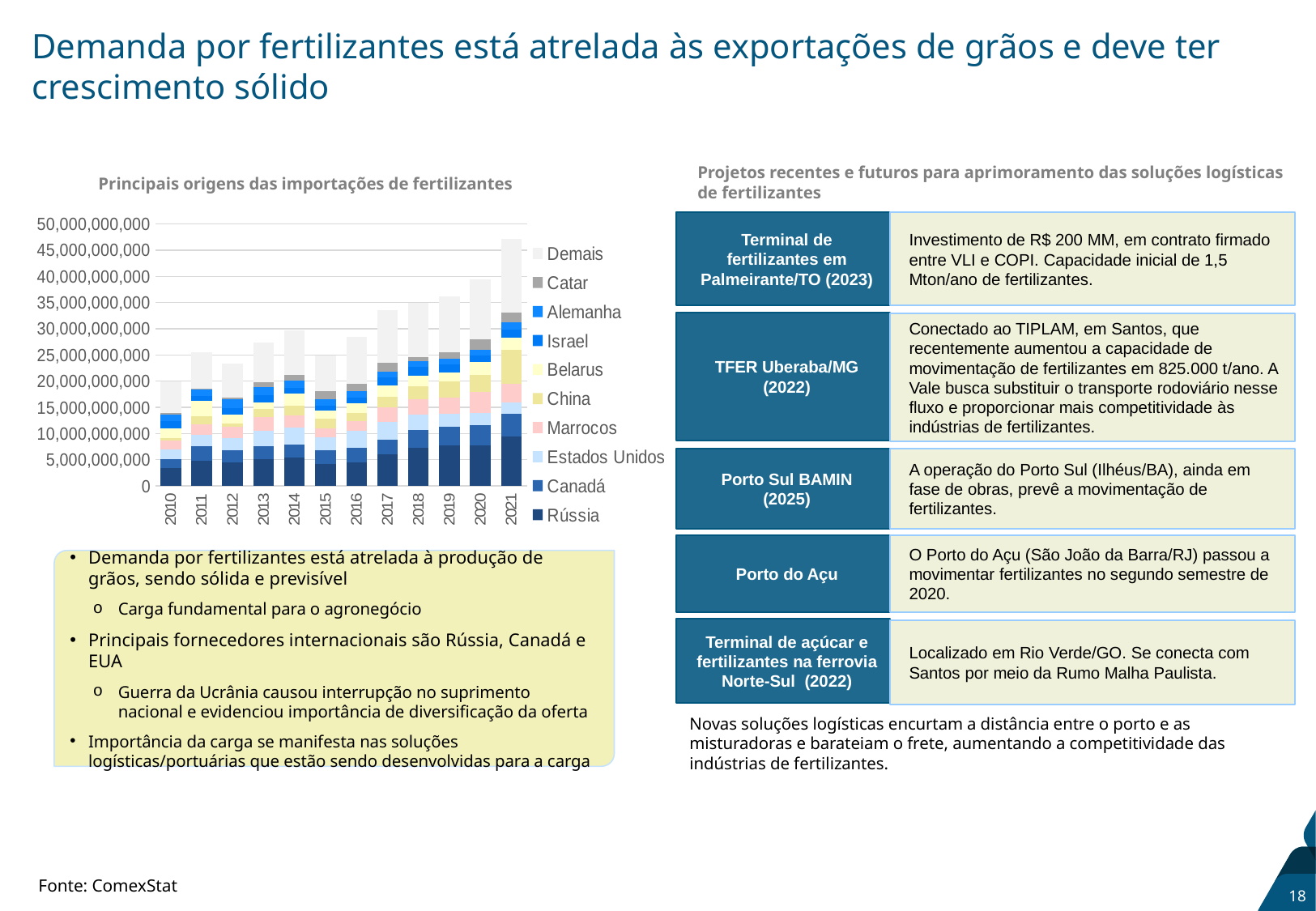
In the chart 'Principais origens das importações de fertilizantes', which year has the tallest stacked bar? 2021 In the chart 'Principais origens das importações de fertilizantes', which year has the shortest stacked bar? 2010 In the chart 'Principais origens das importações de fertilizantes', is the total for 2021 greater or less than 45,000,000,000? greater What is the first entry listed in the legend of the chart 'Principais origens das importações de fertilizantes'? Demais What kind of chart is 'Principais origens das importações de fertilizantes'? Stacked bar chart In the chart 'Principais origens das importações de fertilizantes', do the total imports generally rise or fall from 2010 to 2021? Rise In the chart 'Principais origens das importações de fertilizantes', which series is at the bottom of each stacked bar? Rússia In the chart 'Principais origens das importações de fertilizantes', is the total for 2010 greater or less than 25,000,000,000? less In the chart 'Principais origens das importações de fertilizantes', is the total for 2017 greater or less than 30,000,000,000? greater How many years are shown on the x axis of the chart 'Principais origens das importações de fertilizantes'? 12 How many series does the legend of the chart 'Principais origens das importações de fertilizantes' list? 10 In the chart 'Principais origens das importações de fertilizantes', which year has a larger total, 2011 or 2012? 2011